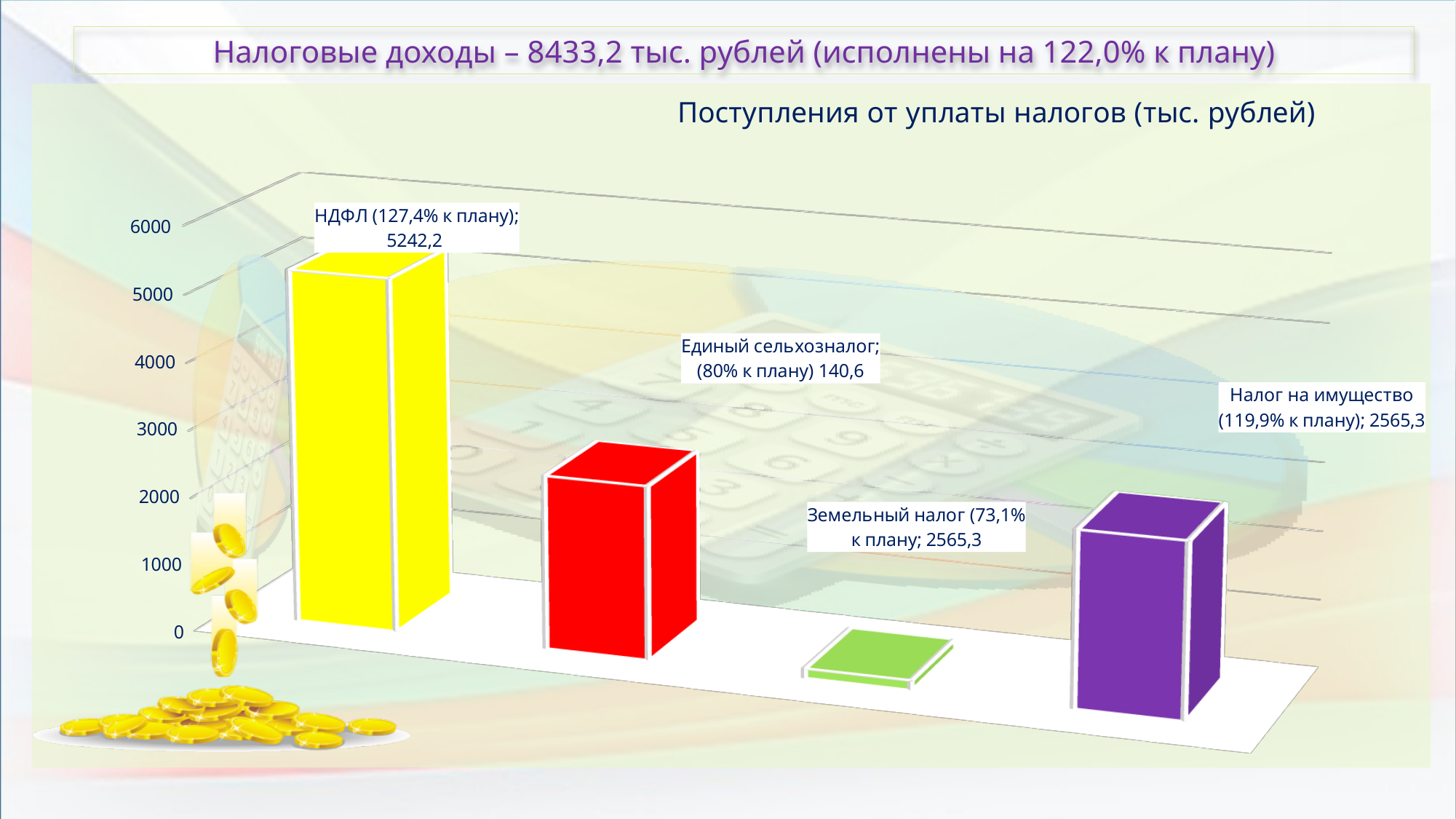
What percentage of plan is shown for Земельный налог? 73,1% What is the title of the chart? Поступления от уплаты налогов (тыс. рублей) Which category has the highest value? НДФЛ What value is labelled for НДФЛ? 5242,2 What percentage of plan is shown for НДФЛ? 127,4% What value is labelled for Единый сельхозналог? 140,6 What value is labelled for Налог на имущество? 2565,3 Is the value for НДФЛ greater or less than 5000? greater What kind of chart is shown on the slide? bar chart How many bars (categories) does the chart show? 4 Which is larger, the value for НДФЛ or the value for Налог на имущество? НДФЛ What is the difference between the values for НДФЛ and Налог на имущество? 2676,9